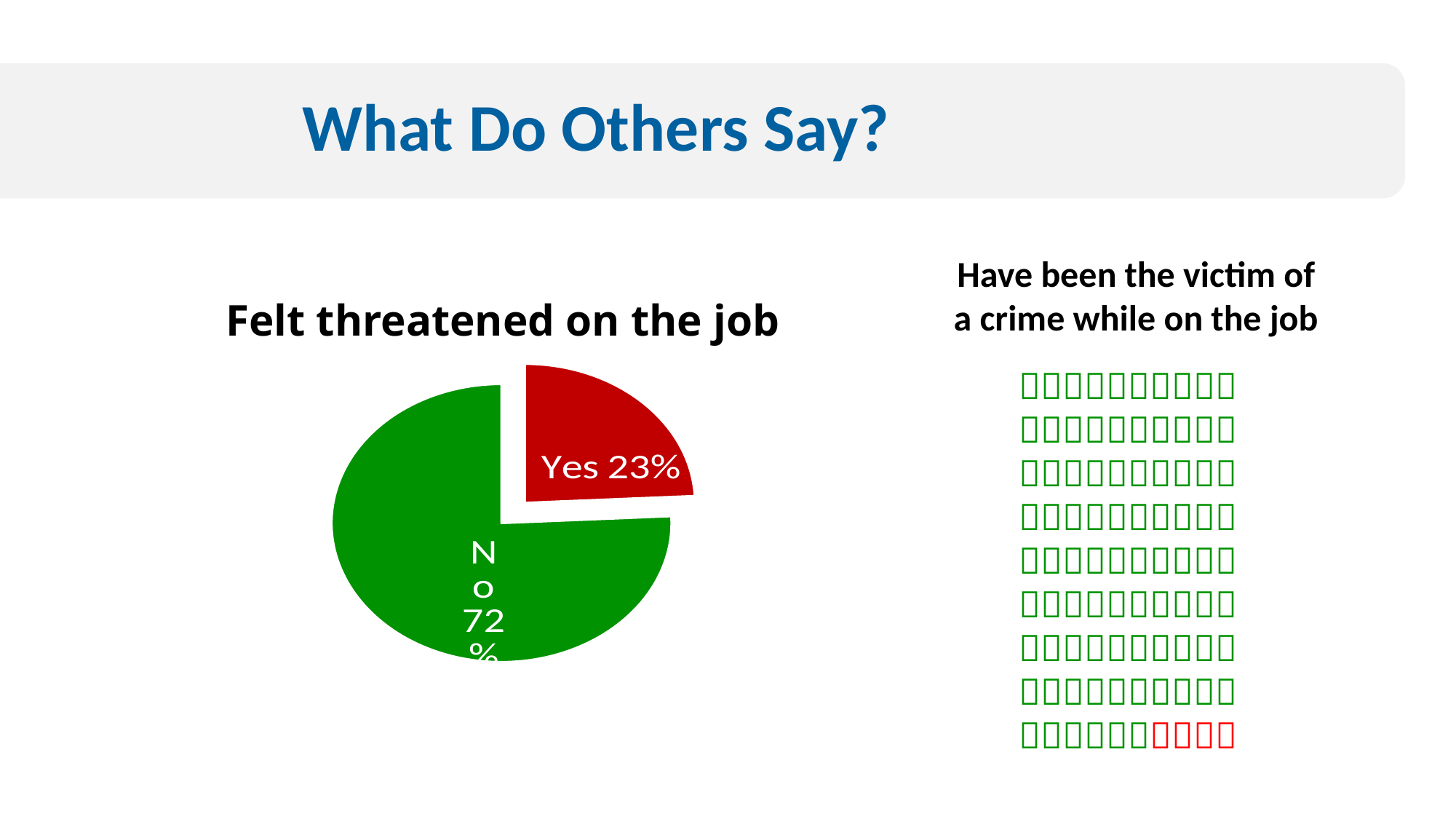
In the pie chart 'Felt threatened on the job', which is larger, the Yes slice or the No slice? No In the pie chart 'Felt threatened on the job', what colour is the Yes slice? Red In the pie chart 'Felt threatened on the job', which response has the largest slice? No In the pie chart 'Felt threatened on the job', which response has the smallest slice? Yes In the pie chart 'Felt threatened on the job', what is the difference between the No and Yes percentages? 49% In the pie chart 'Felt threatened on the job', what percentage answered No? 72% How many slices does the pie chart 'Felt threatened on the job' have? 2 In the icon grid 'Have been the victim of a crime while on the job', how many squares are red? 4 In the pie chart 'Felt threatened on the job', what percentage answered Yes? 23% What is the title of the pie chart on the left of the slide? Felt threatened on the job What kind of chart is used for 'Felt threatened on the job'? Pie chart